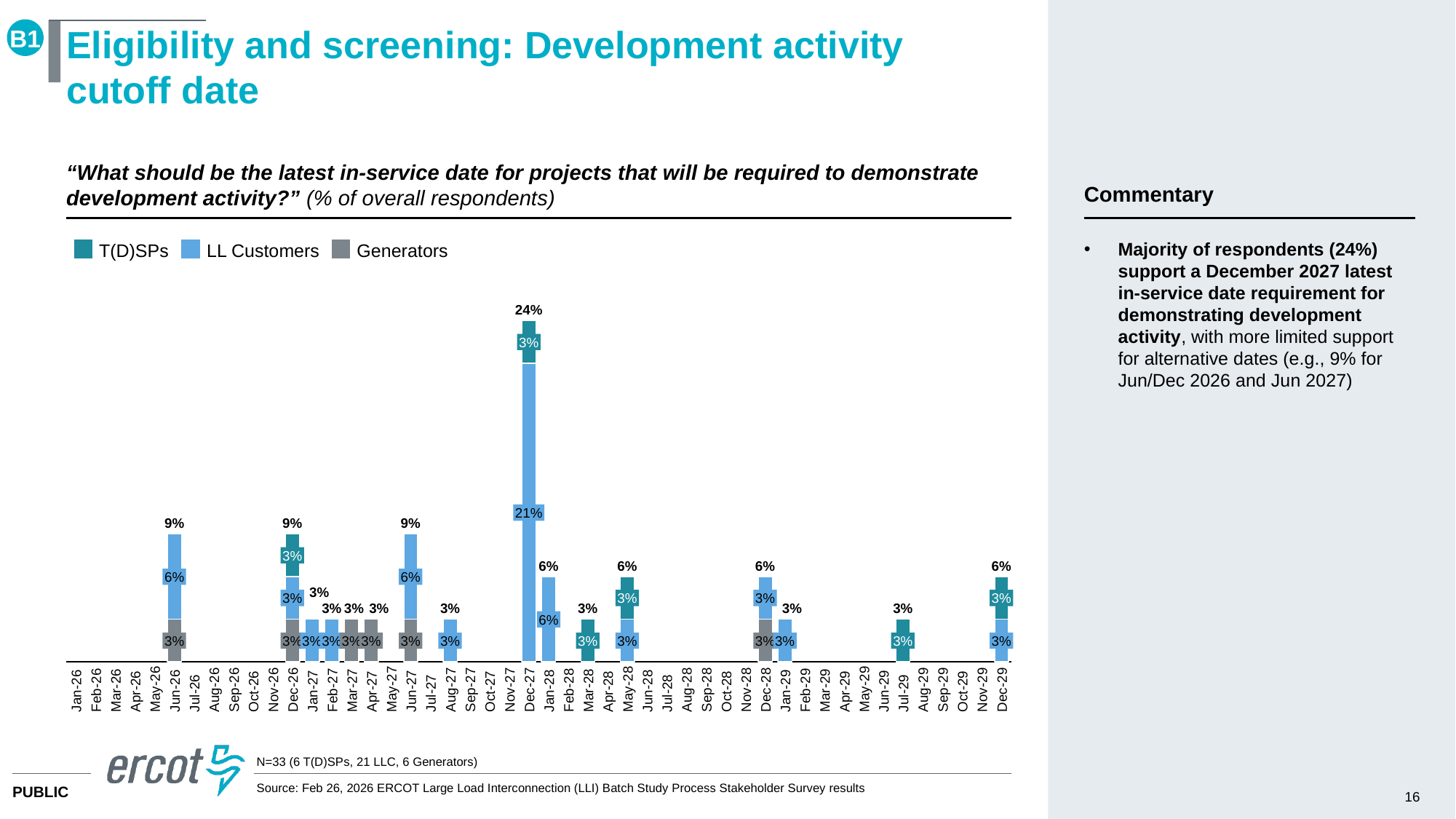
How many series does the legend list? 3 What kind of chart is shown on the slide? Stacked bar chart What is the total of the stacked bar for Jun-26? 9% How many months on the x axis have a bar plotted? 16 Which has a larger total, Jan-28 or Mar-28? Jan-28 What is the Generators value in the Dec-26 bar? 3% Which in-service date has the highest total share of respondents? Dec-27 What is the T(D)SPs value in the Dec-27 bar? 3% What is the total percentage of respondents for Dec-27? 24% What percentage of respondents are LL Customers in the Dec-27 bar? 21% What is the difference between the total for Dec-27 and the total for Jun-27? 15% Which series is shown in gray in the legend? Generators